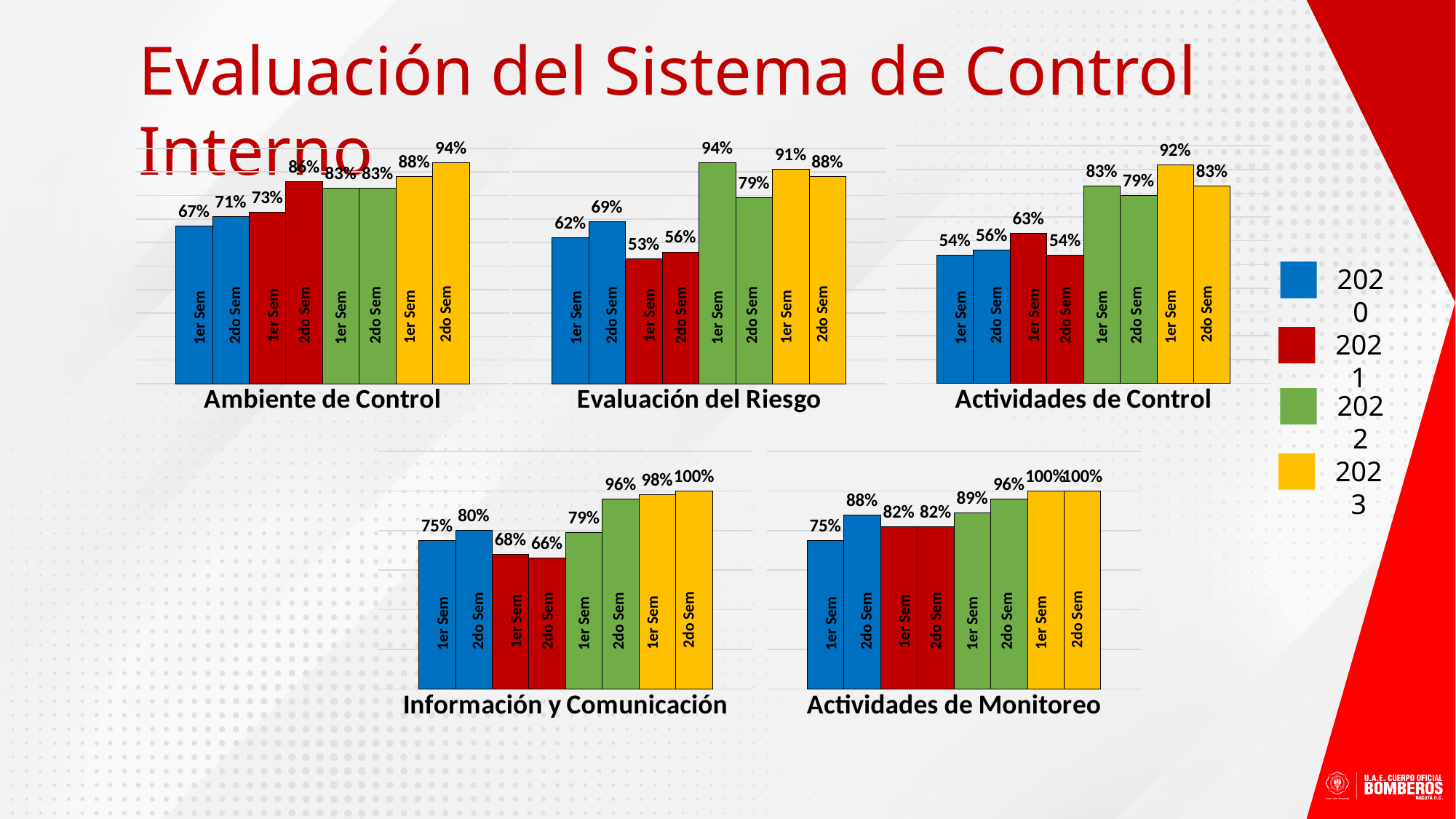
How many series does the legend list? 4 Which colour represents 2023 in the legend? Yellow In the Evaluación del Riesgo chart, what is the value for 1er Sem of 2022? 94% In the Información y Comunicación chart, what is the value for 2do Sem of 2021? 66% In the Información y Comunicación chart, which is larger: 2do Sem 2022 or 1er Sem 2023? 1er Sem 2023 In the Ambiente de Control chart, what is the value for 2do Sem of 2023? 94% In the Evaluación del Riesgo chart, which bar has the lowest value? 1er Sem 2021 (53%) What kind of chart is used for Actividades de Monitoreo? Bar chart In the Actividades de Monitoreo chart, which bar has the lowest value? 1er Sem 2020 (75%) In the Ambiente de Control chart, what is the difference between 2do Sem 2023 and 1er Sem 2020? 27% In the Actividades de Control chart, which bar has the highest value? 1er Sem 2023 (92%) In the Actividades de Control chart, what is the value for 1er Sem of 2021? 63%